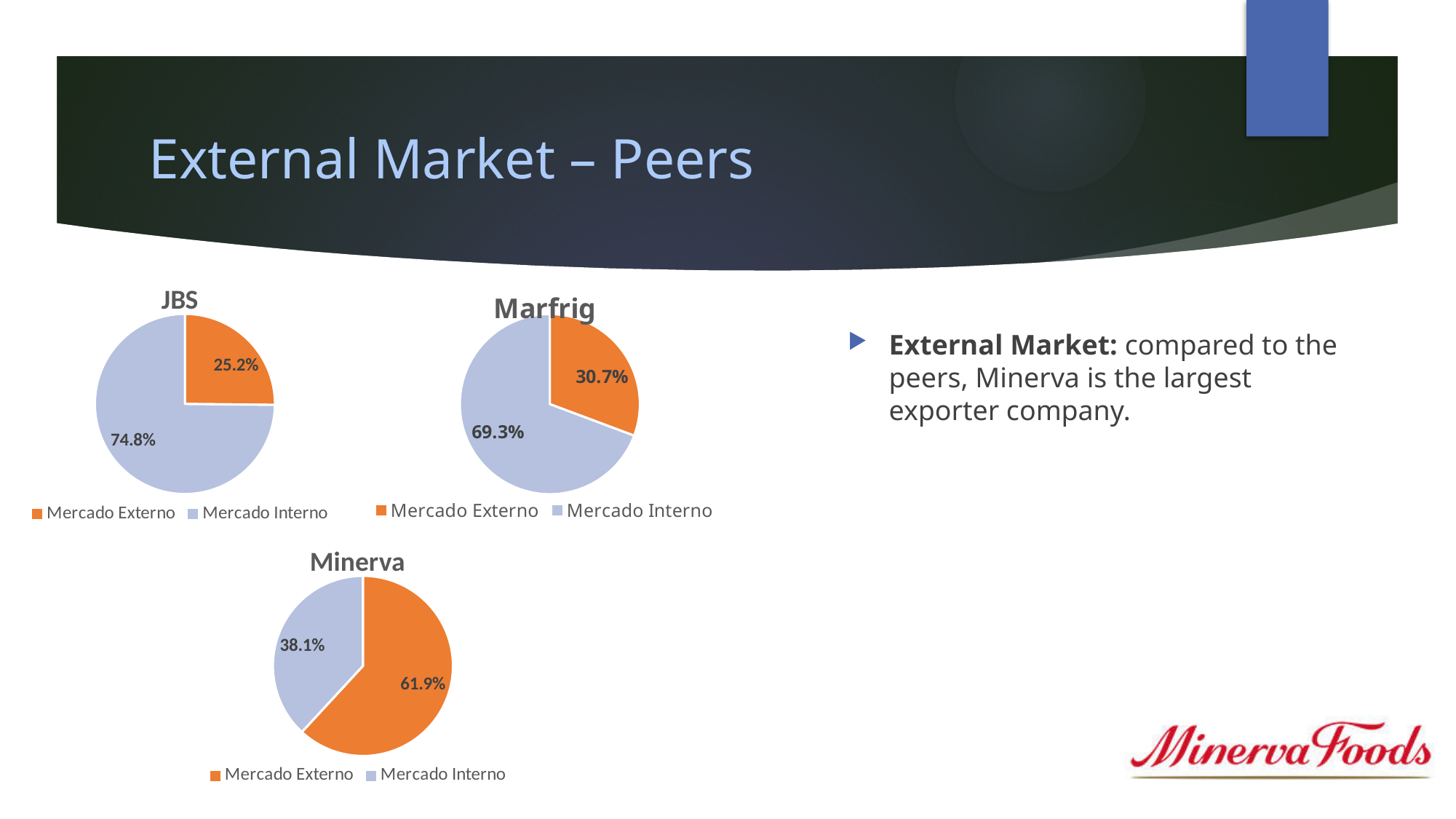
How many entries does the legend of the JBS chart list? 2 In the Minerva chart, what is the share for Mercado Interno? 38.1% In the JBS chart, which slice is the smallest? Mercado Externo What kind of chart is the Minerva chart? Pie chart In the Minerva chart, what is the share for Mercado Externo? 61.9% Which is larger: the Mercado Externo share in the JBS chart or in the Marfrig chart? Marfrig In the Marfrig chart, what is the share for Mercado Externo? 30.7% In the JBS chart, what is the share for Mercado Interno? 74.8% In the Marfrig chart, what is the share for Mercado Interno? 69.3% In the Marfrig chart, what is the difference between the Mercado Interno and Mercado Externo shares? 38.6% In the JBS chart, what is the share for Mercado Externo? 25.2% In the Minerva chart, which slice is the largest? Mercado Externo